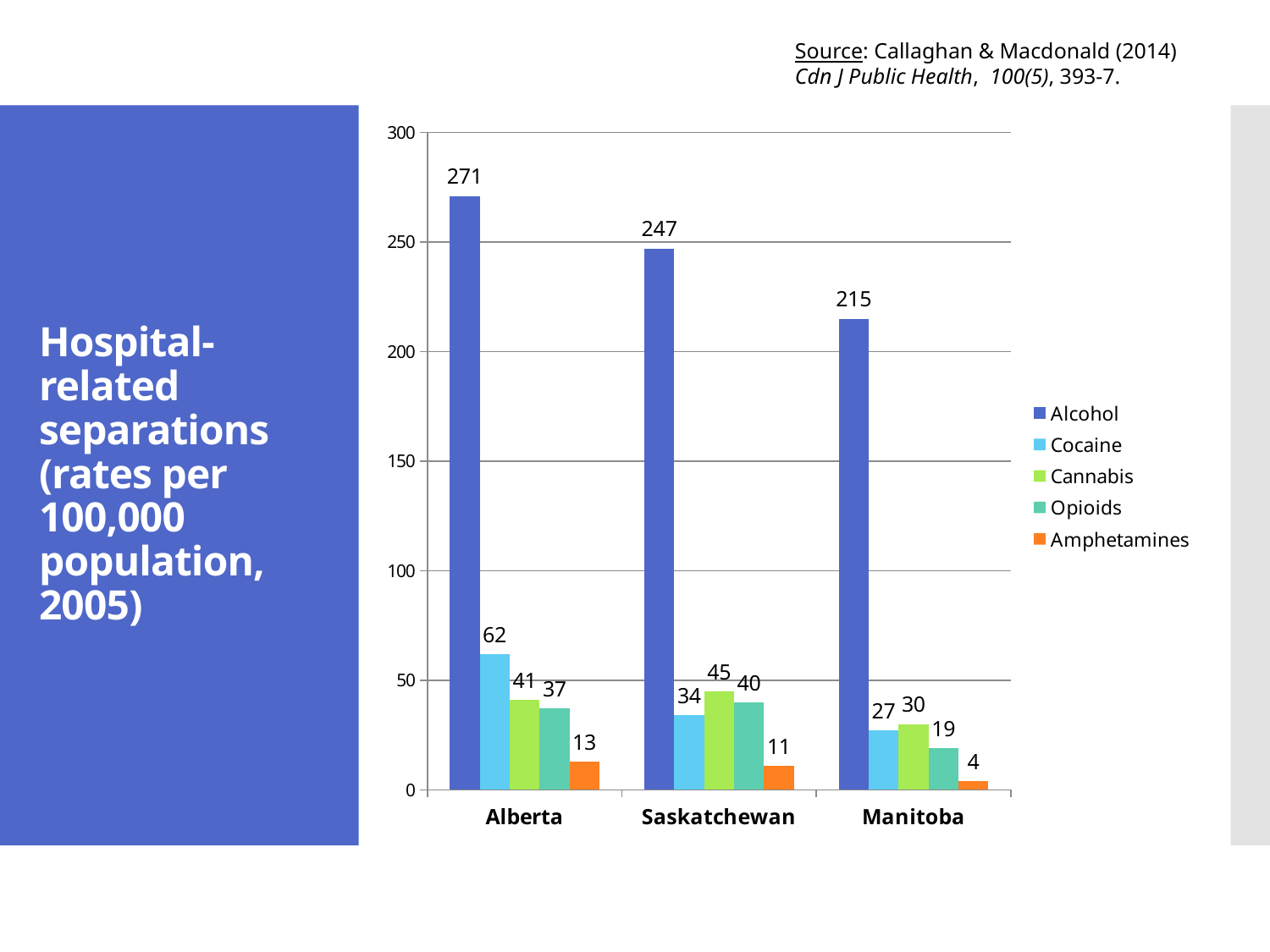
Which is larger, the Cannabis value for Saskatchewan or the Cannabis value for Alberta? Saskatchewan What is the difference between the Alcohol values for Alberta and Manitoba? 56 Which series is shown in orange in the legend? Amphetamines Which province has the highest Alcohol value? Alberta How many provinces are shown on the x axis? 3 Which province has the lowest Cocaine value? Manitoba What is the Opioids value for Alberta? 37 How many series does the legend list? 5 What is the Cocaine value for Saskatchewan? 34 What is the Amphetamines value for Manitoba? 4 What kind of chart is shown on the slide? Bar chart What is the Alcohol value for Alberta? 271